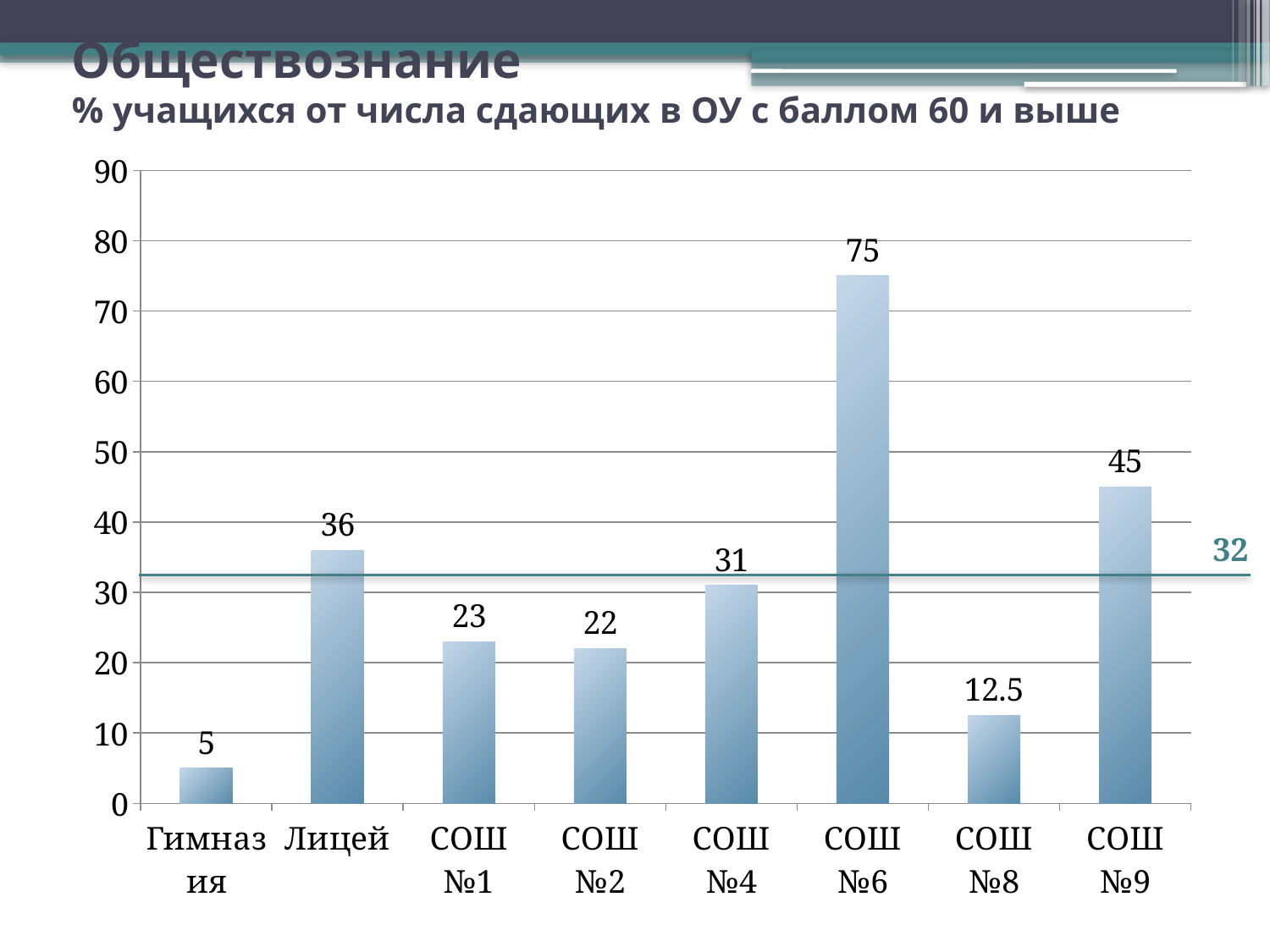
Which is larger, the value for Лицей or the value for СОШ №9? СОШ №9 What is the difference between the values for Лицей and СОШ №4? 5 Is the value for СОШ №6 greater or less than 70? greater What is the value for СОШ №6? 75 What value is marked by the horizontal reference line across the chart? 32 What is the value for СОШ №8? 12.5 How many categories are shown on the x axis? 8 Which category has the highest value? СОШ №6 Which category has the lowest value? Гимназия What kind of chart is shown on the slide? bar chart What is the difference between the values for СОШ №6 and СОШ №9? 30 What is the value for Гимназия? 5